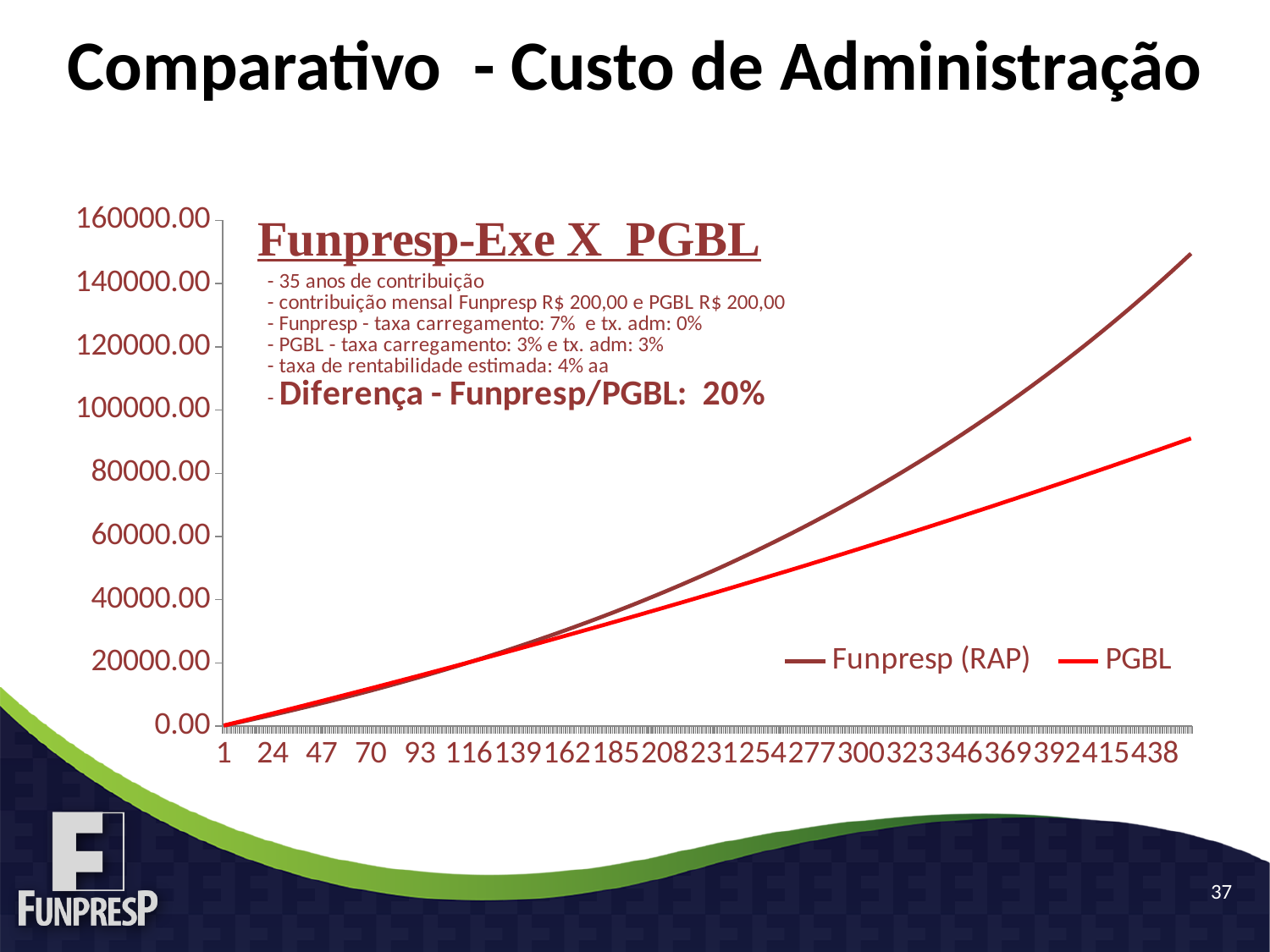
What are the two series named in the chart legend? Funpresp (RAP) and PGBL Which series has the lower value at the right end of the chart? PGBL How many series does the chart legend list? 2 Is the final value of the PGBL series greater or less than 80000? greater Do the values of the PGBL series rise or fall along the x axis? rise Which series is drawn in bright red? PGBL Do the values of the Funpresp (RAP) series rise or fall along the x axis? rise What kind of chart is shown on the slide? line chart Which series ends at the higher value at the right end of the x axis? Funpresp (RAP) What is the highest value shown on the y axis of the chart? 160000.00 Is the final value of the PGBL series greater or less than 100000? less Is the final value of the Funpresp (RAP) series greater or less than 140000? greater